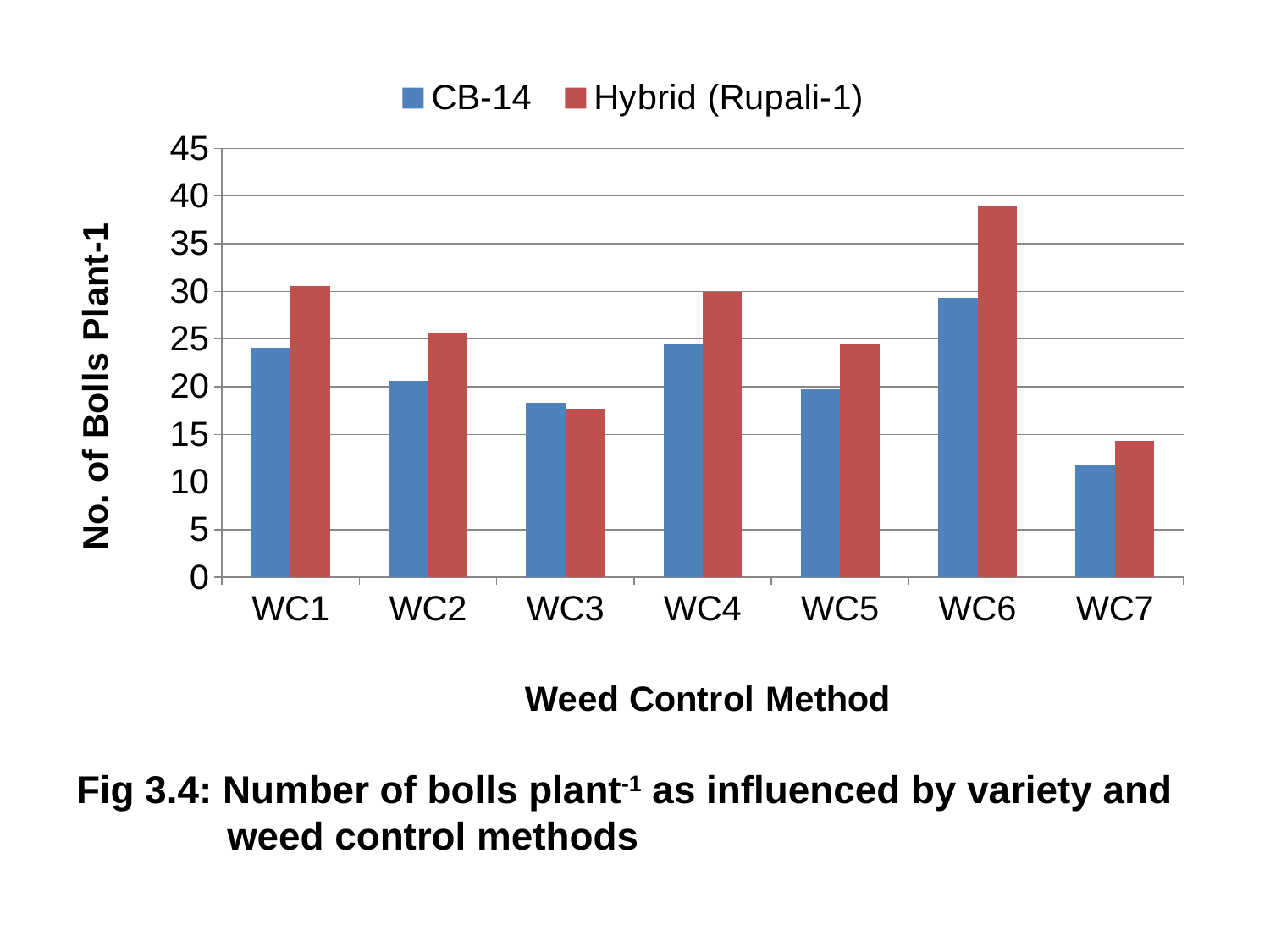
Which weed control method has the highest value for CB-14? WC6 How many weed control methods are shown on the x axis? 7 Is the value for Hybrid (Rupali-1) at WC6 greater or less than 35? greater How many series does the legend list? 2 What is the label of the y axis? No. of Bolls Plant-1 Which weed control method has the highest value for Hybrid (Rupali-1)? WC6 What kind of chart is shown on the slide? bar chart Is the value for CB-14 at WC7 greater or less than 15? less Is the value for Hybrid (Rupali-1) at WC4 greater or less than 25? greater Which weed control method has the lowest value for Hybrid (Rupali-1)? WC7 For WC6, which series has the larger value, CB-14 or Hybrid (Rupali-1)? Hybrid (Rupali-1) Which weed control method has the lowest value for CB-14? WC7